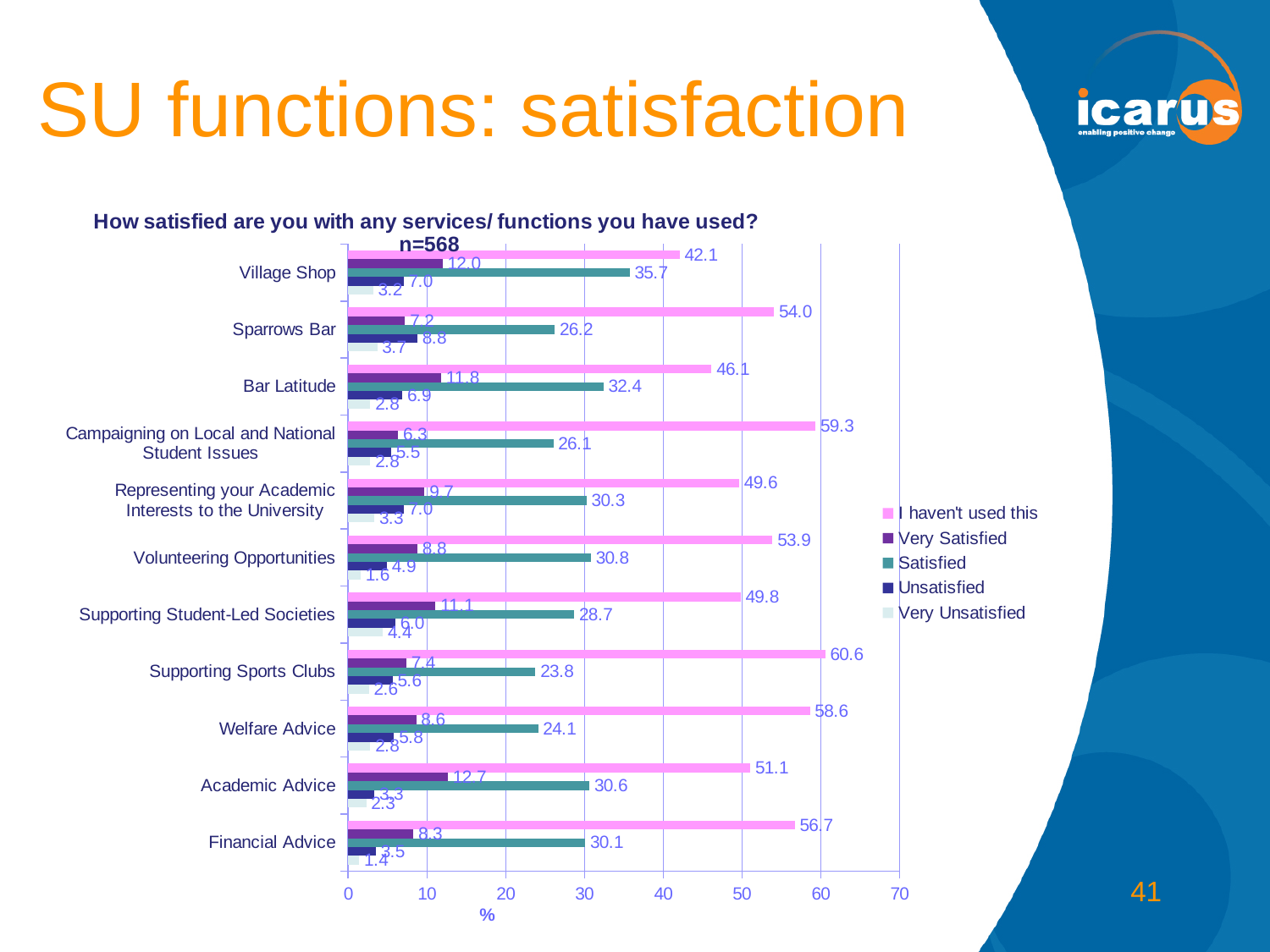
Which has a larger 'Satisfied' value, Bar Latitude or Welfare Advice? Bar Latitude What is the 'I haven't used this' value for Village Shop? 42.1 How many series does the legend list? 5 What kind of chart is shown on the slide? bar chart How many services/functions are listed on the chart? 11 What is the 'Very Satisfied' value for Academic Advice? 12.7 Which service has the highest 'Satisfied' value? Village Shop What is the sample size (n) shown in the chart title? n=568 Which service has the highest 'I haven't used this' value? Supporting Sports Clubs Which service has the lowest 'Satisfied' value? Supporting Sports Clubs For Sparrows Bar, what is the difference between the 'I haven't used this' value and the 'Satisfied' value? 27.8 What is the 'Satisfied' value for Bar Latitude? 32.4